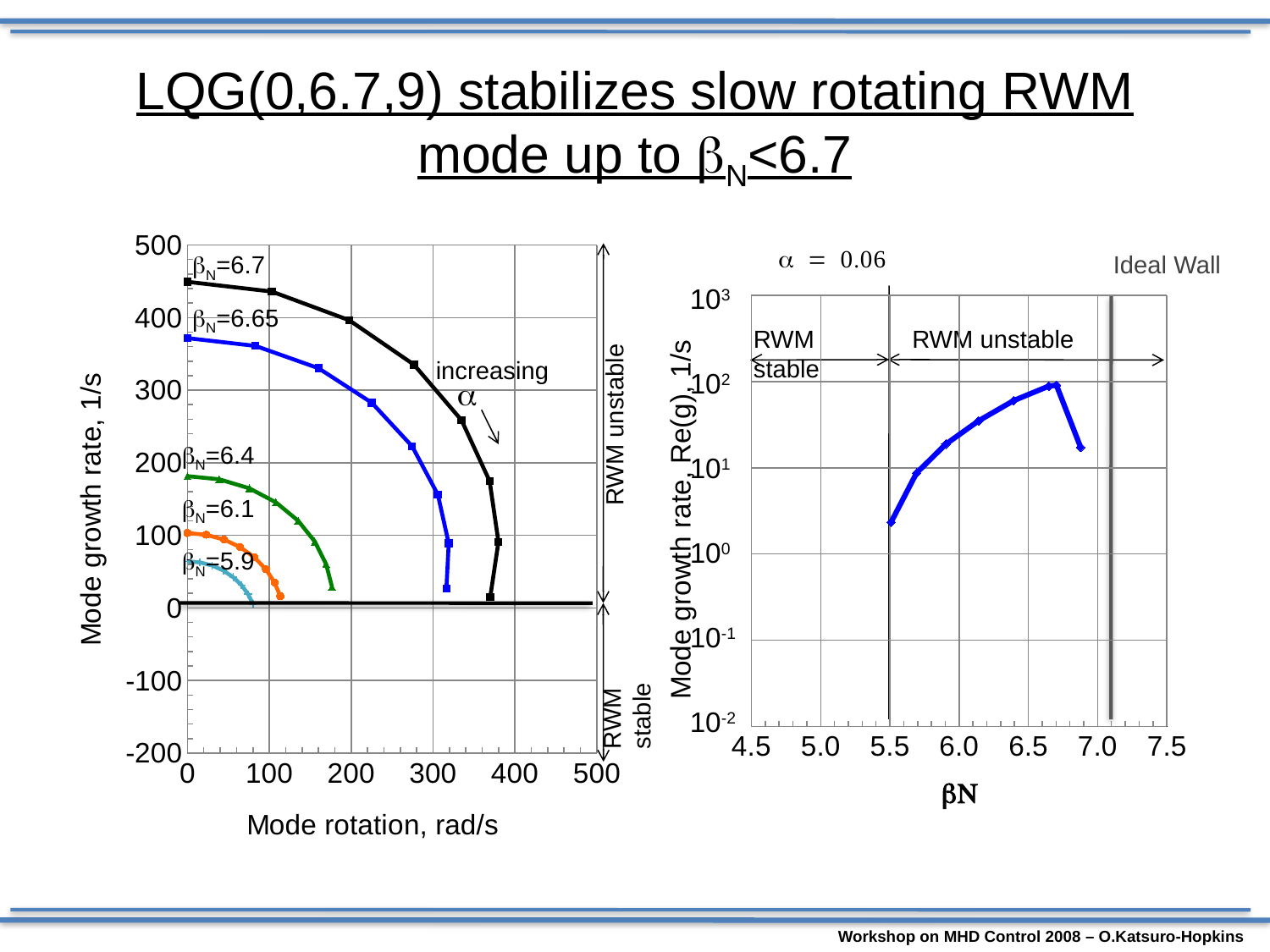
What is the x-axis label of the left chart? Mode rotation, rad/s On the left chart, which βN curve has the highest mode growth rate at zero mode rotation? βN=6.7 On the left chart, is the mode growth rate of the βN=6.4 curve at zero rotation greater or less than 200? less On the left chart, as mode rotation increases, does the mode growth rate of each curve rise or fall? fall On the right chart, is the mode growth rate at βN=5.5 greater or less than 10^1? less On the left chart, which βN curve has the lowest mode growth rate at zero mode rotation? βN=5.9 On the left chart, does the βN=6.7 curve reach zero growth rate at a mode rotation greater or less than 300 rad/s? greater On the right chart (Mode growth rate Re(g) vs βN), what value of α is stated above the plot? 0.06 On the right chart, which has the larger mode growth rate: βN=5.5 or βN=6.7? βN=6.7 What kind of chart is the left chart? line chart On the left chart (Mode growth rate vs Mode rotation), how many βN curves are plotted? 5